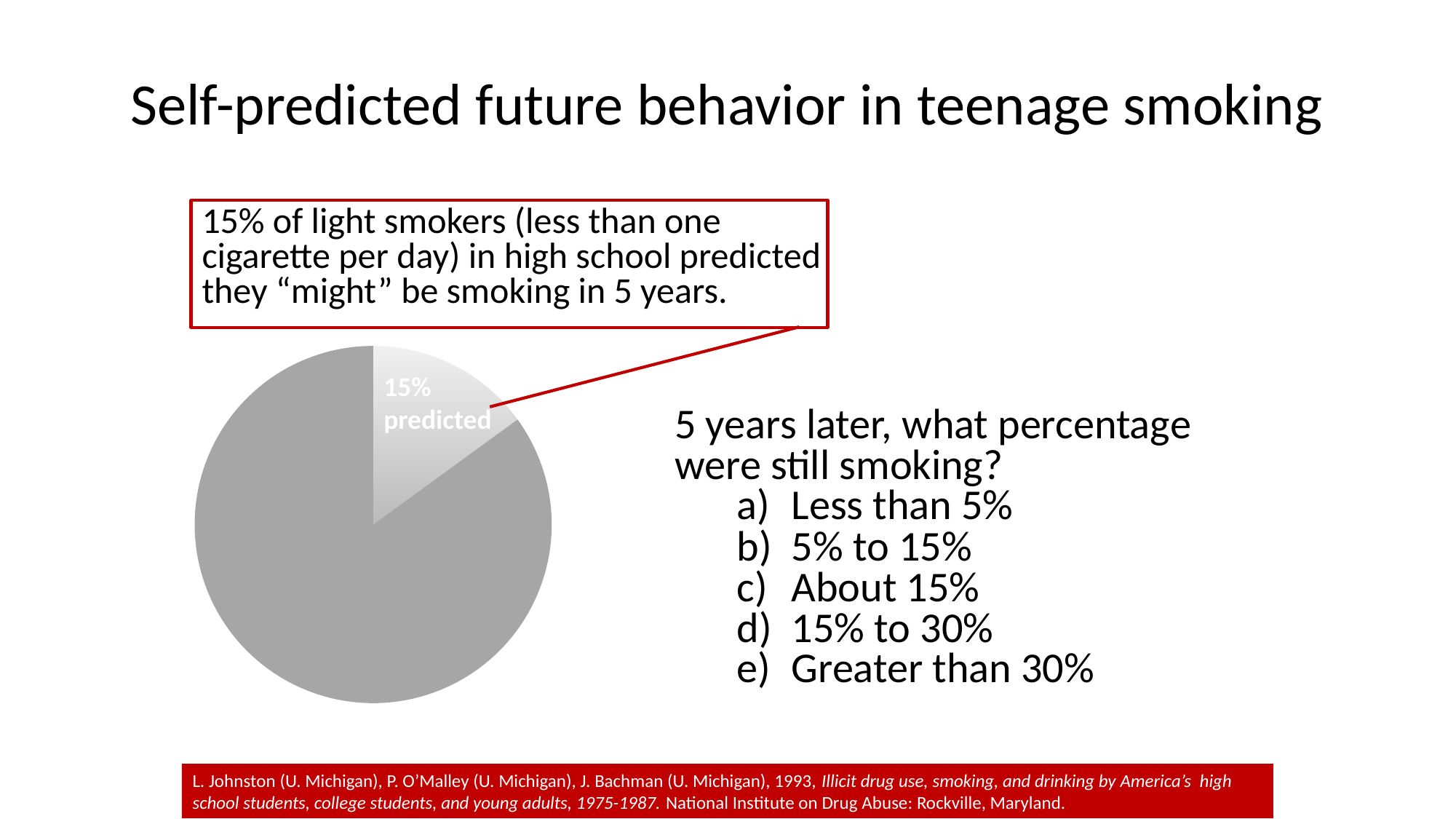
Is the slice labeled "15% predicted" greater or less than 50% of the pie? less What value is printed on the labeled slice of the pie chart? 15% How many slices does the pie chart have? 2 What colour is the slice labeled "15% predicted" compared with the rest of the pie? lighter grey What text label is printed inside the smaller slice of the pie chart? 15% predicted What kind of chart is shown on the slide? pie chart Which slice of the pie chart is the smallest? 15% predicted Which slice of the pie chart is larger, the slice labeled "15% predicted" or the unlabeled slice? the unlabeled slice What share of the pie does the slice labeled "15% predicted" represent? 15%